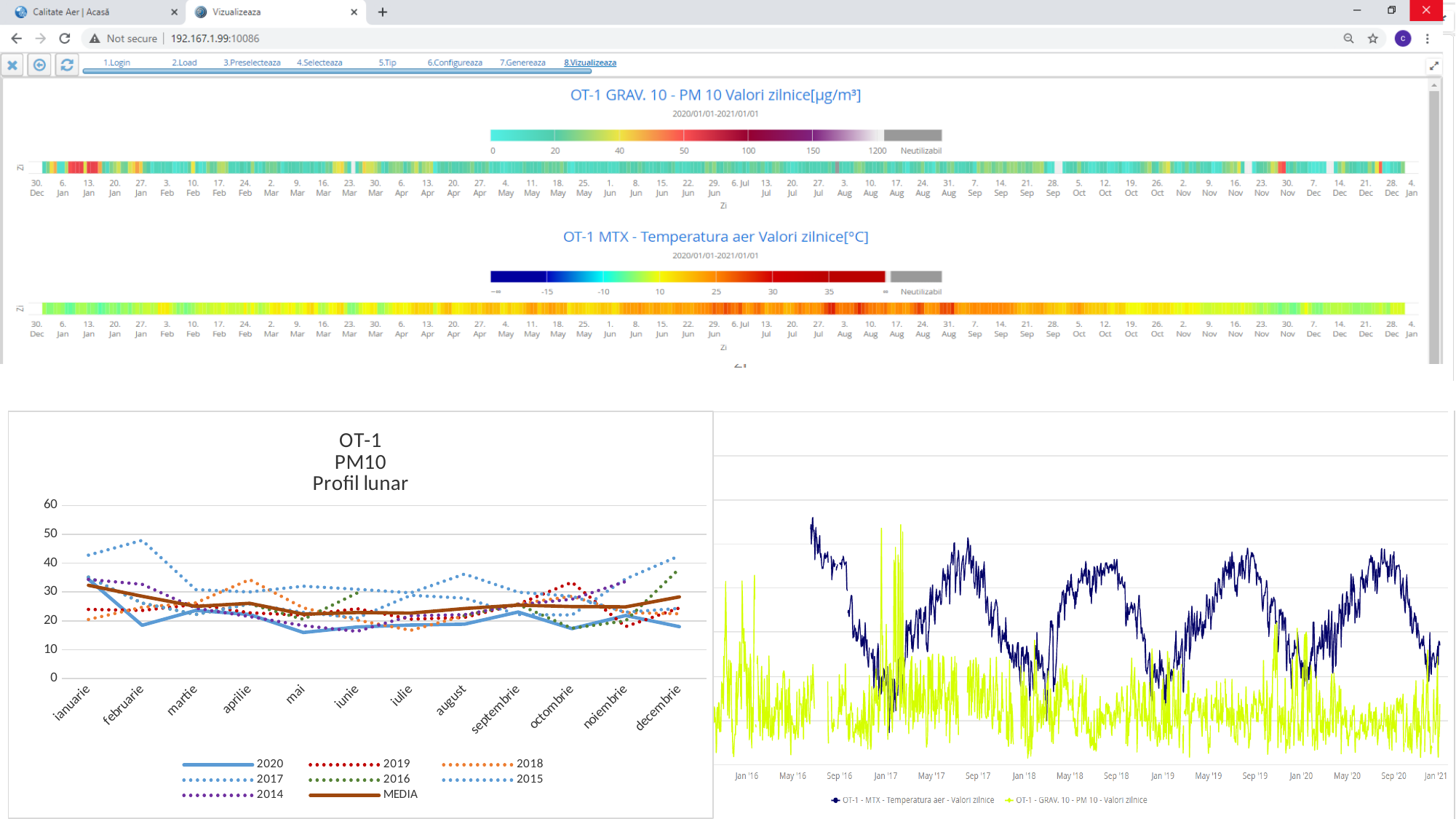
In the bottom-left chart 'OT-1 PM10 Profil lunar', how many months are shown on the x axis? 12 In the bottom-left chart 'OT-1 PM10 Profil lunar', does the 2020 series rise or fall from ianuarie to februarie? fall What is the title of the top chart on the slide? OT-1 GRAV. 10 - PM 10 Valori zilnice[µg/m³] In the bottom-left chart 'OT-1 PM10 Profil lunar', in which month does the 2017 series reach its highest value? februarie In the bottom-left chart 'OT-1 PM10 Profil lunar', is the value for 2020 in mai greater or less than 20? less In the bottom-left chart 'OT-1 PM10 Profil lunar', which is larger in februarie: the 2017 value or the 2020 value? 2017 In the bottom-left chart 'OT-1 PM10 Profil lunar', is the value for 2016 in decembrie greater or less than 30? greater In the bottom-left chart 'OT-1 PM10 Profil lunar', is the value for 2017 in februarie greater or less than 40? greater In the bottom-left chart 'OT-1 PM10 Profil lunar', how many series does the legend list? 8 What kind of chart is the bottom-left chart titled 'OT-1 PM10 Profil lunar'? line chart In the bottom-right time series chart, how many series does the legend list? 2